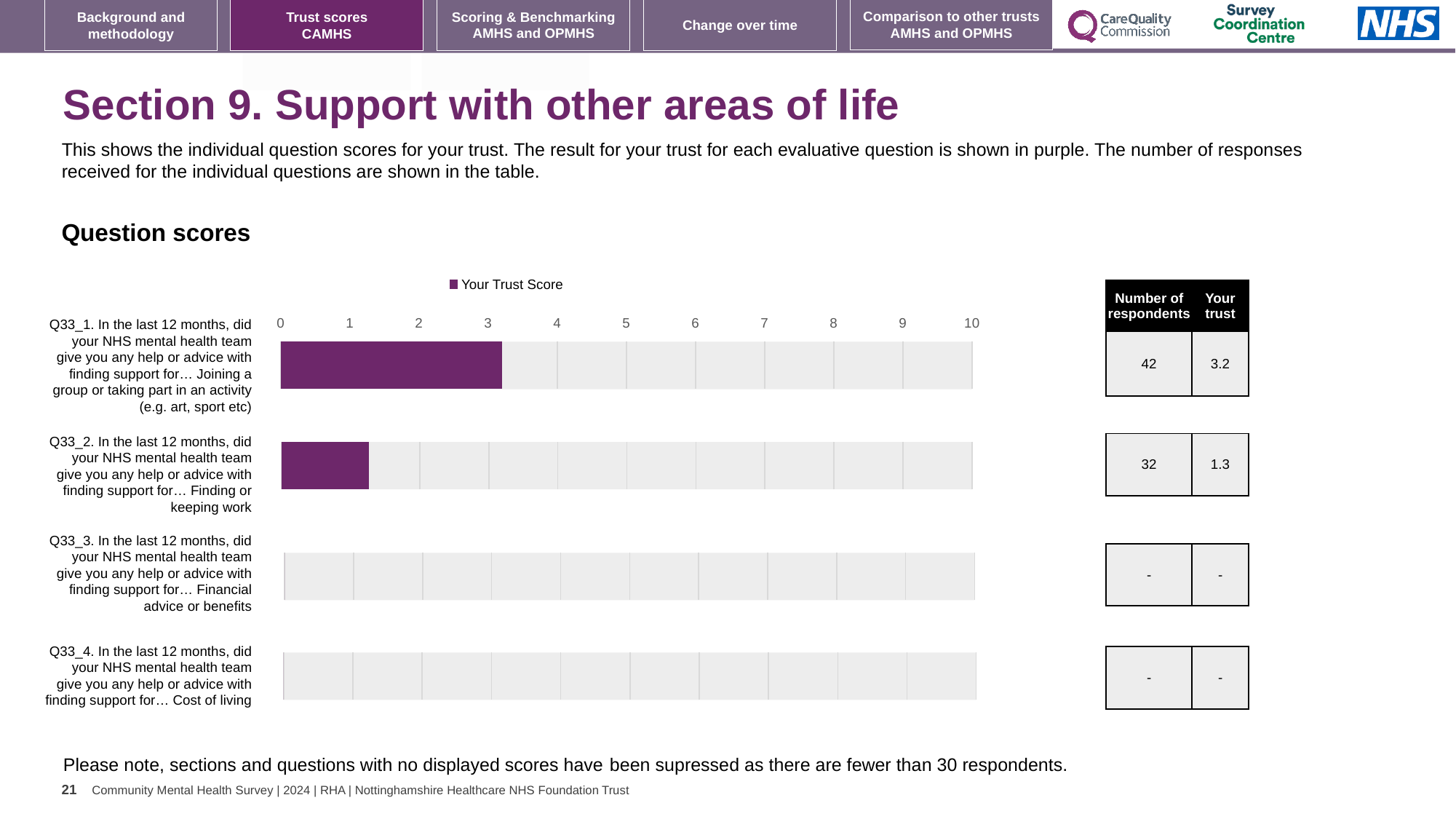
What is the difference between the Your Trust scores for Q33_1 and Q33_2? 1.9 What is the Your Trust score for Q33_2 (Finding or keeping work)? 1.3 Is the Your Trust score for Q33_1 greater or less than 3? greater How many series does the chart legend list? 1 How many respondents answered Q33_2? 32 What is the Your Trust score for Q33_1 (Joining a group or taking part in an activity)? 3.2 How many questions (categories) are listed on the chart? 4 What is the maximum value shown on the chart's x axis? 10 Which question has the highest Your Trust score on the chart? Q33_1 How many respondents answered Q33_1? 42 Which has a larger Your Trust score, Q33_1 or Q33_2? Q33_1 What kind of chart is used to show the question scores? bar chart